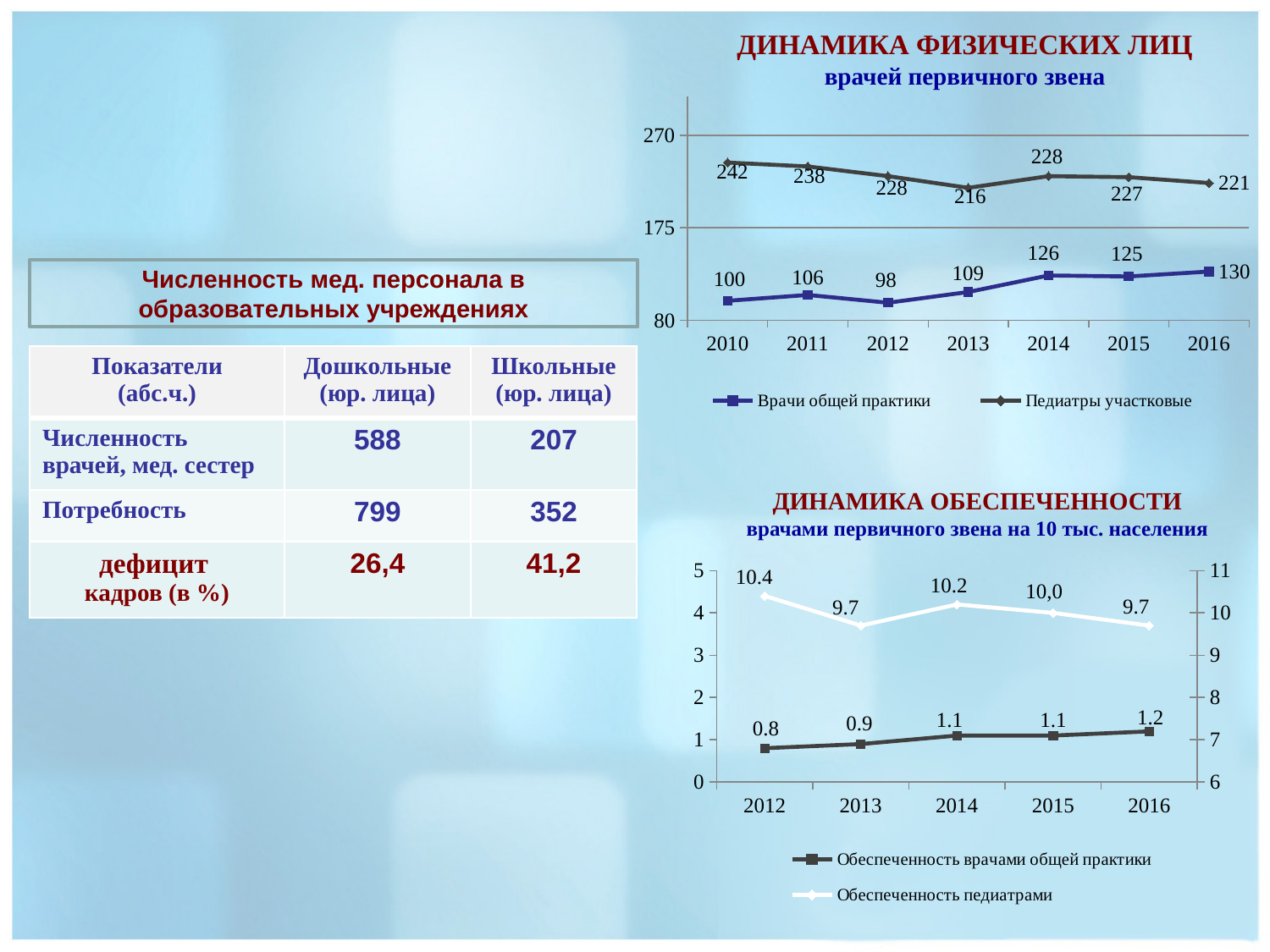
In the chart 'ДИНАМИКА ФИЗИЧЕСКИХ ЛИЦ', in which year is the value for 'Педиатры участковые' lowest? 2013 In the chart 'ДИНАМИКА ОБЕСПЕЧЕННОСТИ', what is the value for 'Обеспеченность педиатрами' in 2014? 10.2 In the chart 'ДИНАМИКА ОБЕСПЕЧЕННОСТИ', which is larger in 2016: 'Обеспеченность педиатрами' or 'Обеспеченность врачами общей практики'? Обеспеченность педиатрами In the chart 'ДИНАМИКА ФИЗИЧЕСКИХ ЛИЦ', what is the value for 'Врачи общей практики' in 2013? 109 In the chart 'ДИНАМИКА ФИЗИЧЕСКИХ ЛИЦ', how many years are shown on the x axis? 7 How many series does the legend of the chart 'ДИНАМИКА ОБЕСПЕЧЕННОСТИ' list? 2 In the chart 'ДИНАМИКА ФИЗИЧЕСКИХ ЛИЦ', does the value for 'Педиатры участковые' generally rise or fall from 2010 to 2016? fall In the chart 'ДИНАМИКА ОБЕСПЕЧЕННОСТИ', what is the value for 'Обеспеченность врачами общей практики' in 2012? 0.8 What kind of chart is 'ДИНАМИКА ОБЕСПЕЧЕННОСТИ'? line chart In the chart 'ДИНАМИКА ФИЗИЧЕСКИХ ЛИЦ', in which year is the value for 'Врачи общей практики' highest? 2016 In the chart 'ДИНАМИКА ФИЗИЧЕСКИХ ЛИЦ', what is the value for 'Педиатры участковые' in 2016? 221 In the chart 'ДИНАМИКА ФИЗИЧЕСКИХ ЛИЦ', what is the difference between 'Педиатры участковые' and 'Врачи общей практики' in 2010? 142